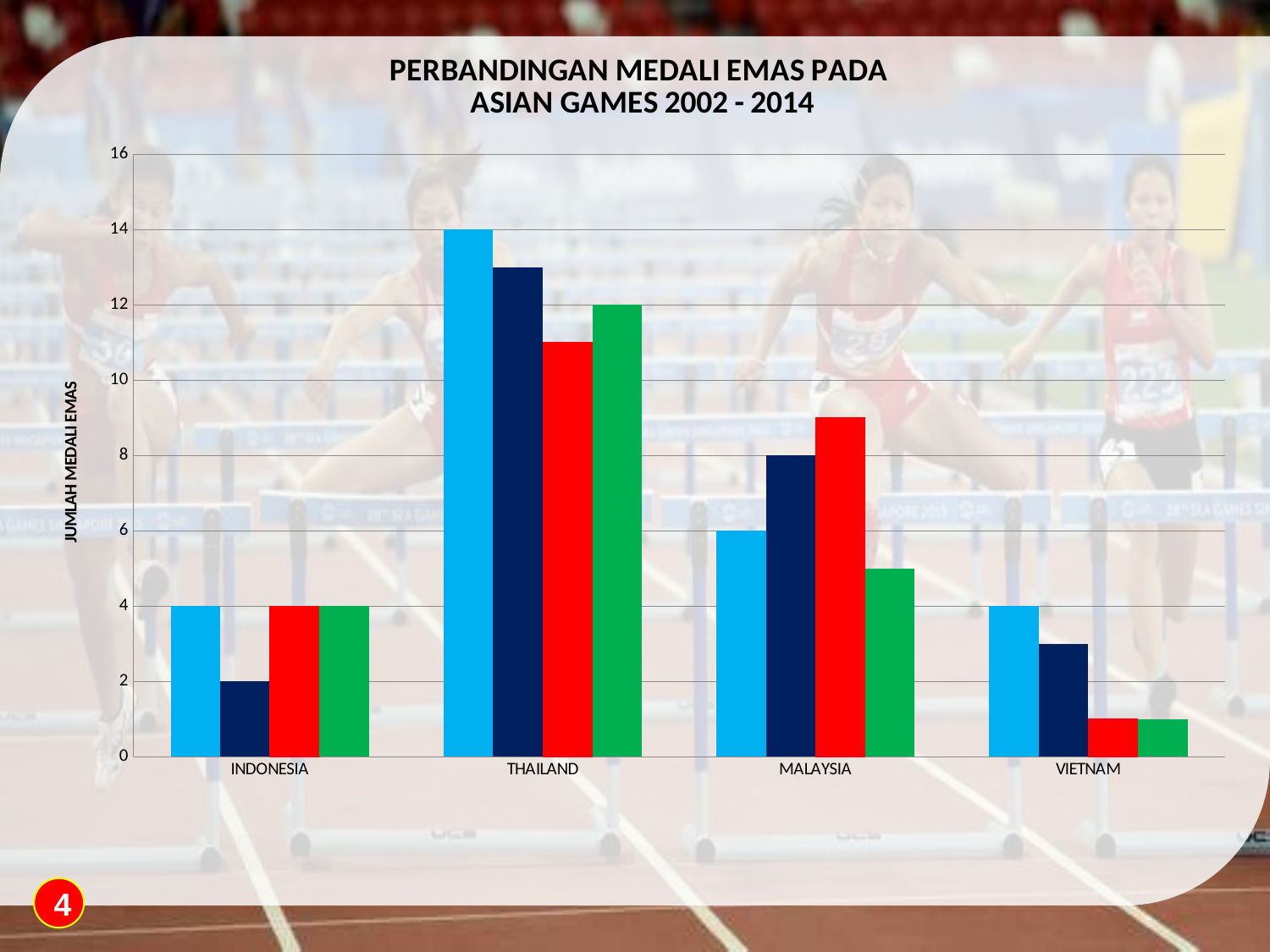
What is the value of the light blue bar for VIETNAM? 4 How many countries are shown on the x axis of the chart? 4 What is the value of the light blue bar for THAILAND? 14 How many bars are plotted for each country in the chart? 4 What is the value of the dark navy bar for INDONESIA? 2 Which country has the tallest bar in the chart? THAILAND What is the value of the dark navy bar for MALAYSIA? 8 Which is larger: the light blue bar for MALAYSIA or the light blue bar for INDONESIA? MALAYSIA Is the value of the red bar for THAILAND greater or less than 10? greater What is the label on the vertical axis of the chart? JUMLAH MEDALI EMAS What kind of chart is shown on the slide? bar chart What is the value of the green bar for THAILAND? 12